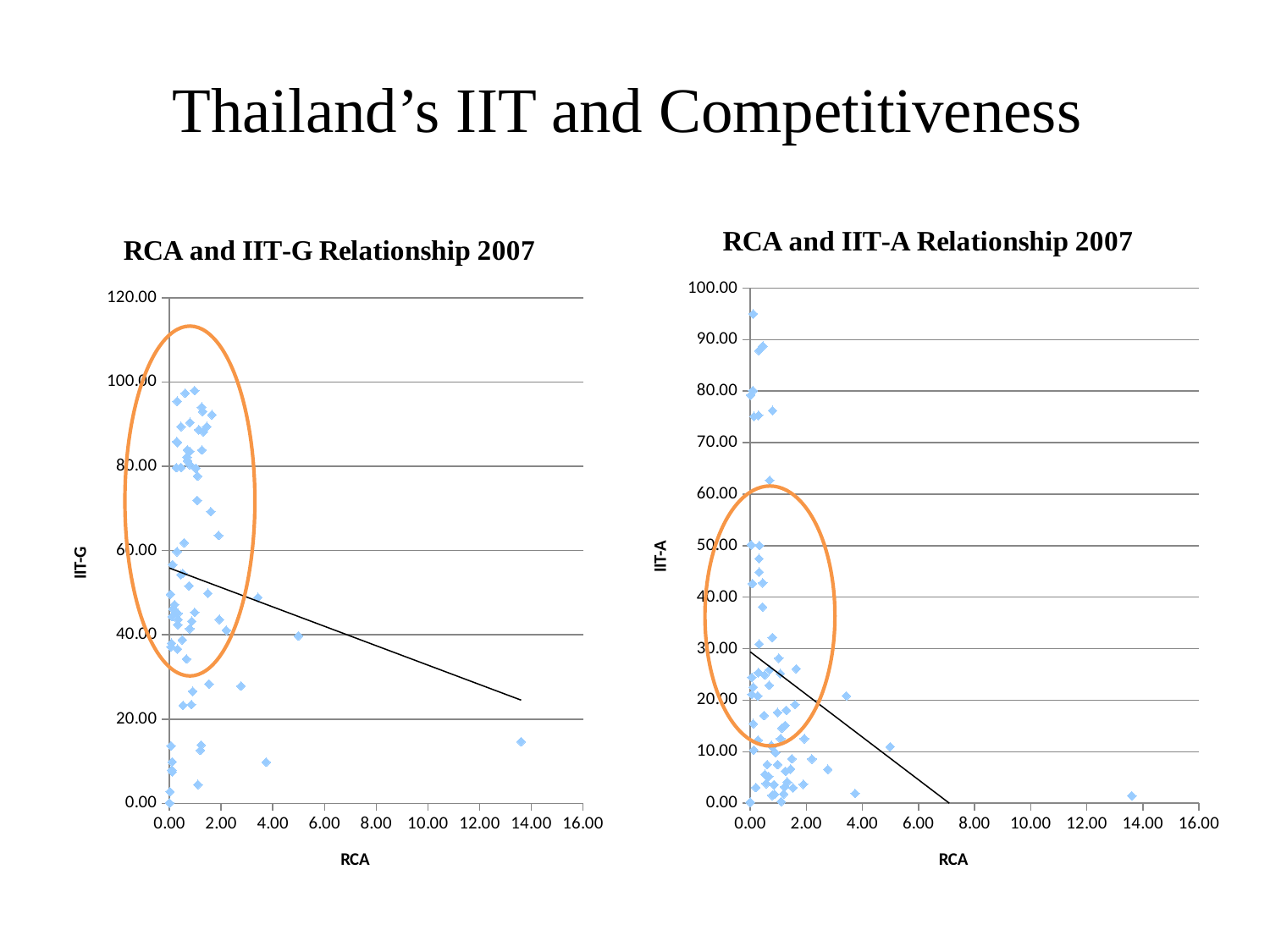
What is the maximum value shown on the vertical axis of the left chart? 120.00 What is the label of the vertical axis on the left chart? IIT-G In the right chart, is the highest plotted IIT-A value greater or less than 90.00? greater What is the maximum value shown on the vertical axis of the right chart? 100.00 In the left chart, is the IIT-G value of the point with the largest RCA (near 14.00) greater or less than 20.00? less What is the label of the horizontal axis on the right chart? RCA In the left chart, is the highest plotted IIT-G value greater or less than 100.00? less What kind of chart is the right chart titled "RCA and IIT-A Relationship 2007"? scatter chart In the right chart, does the fitted trend line rise or fall as RCA increases? falls What kind of chart is the left chart titled "RCA and IIT-G Relationship 2007"? scatter chart In the left chart, does the fitted trend line rise or fall as RCA increases? falls